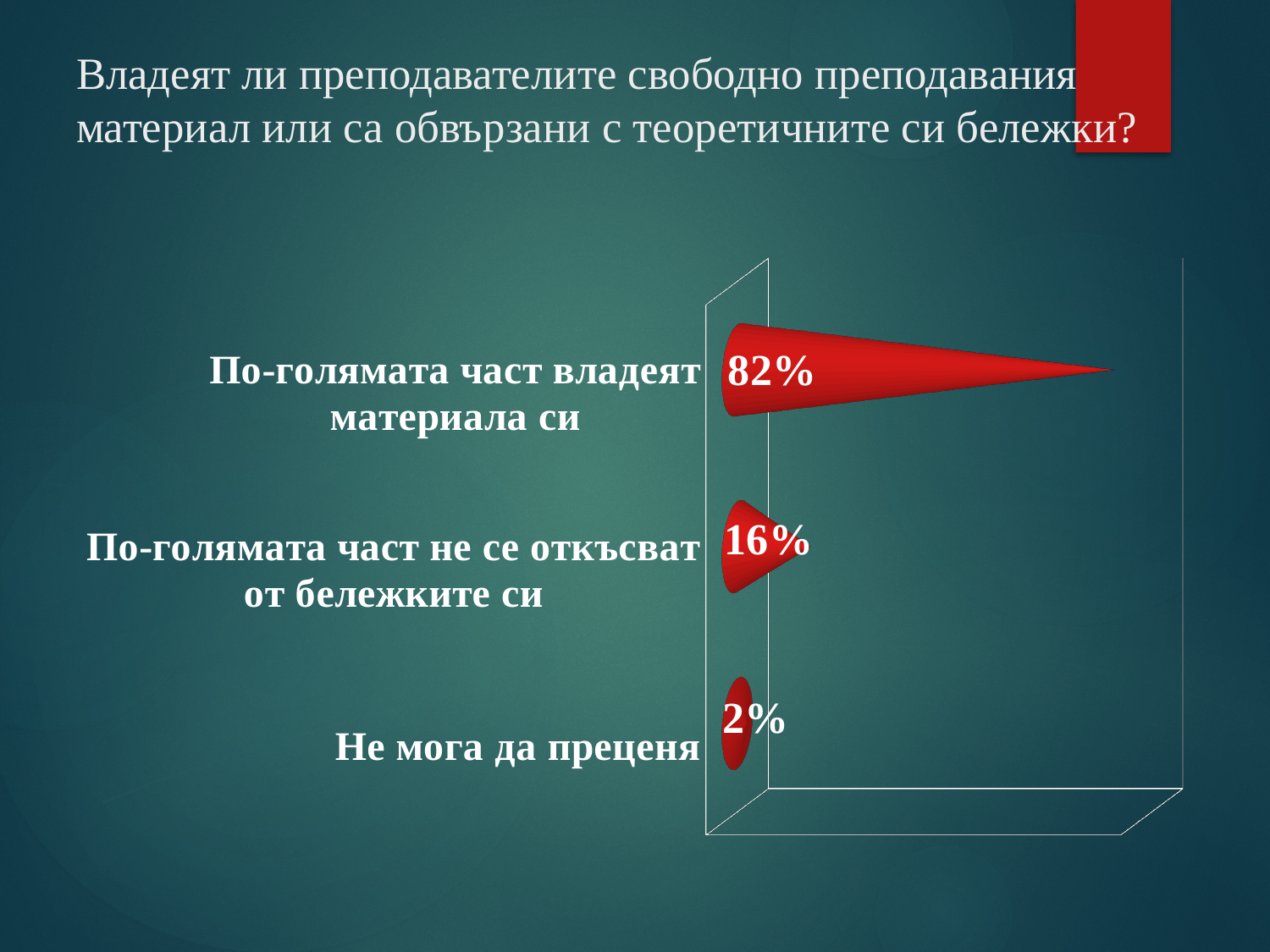
What is the total of the three values shown in the chart? 100% Which is larger: the value for "По-голямата част не се откъсват от бележките си" or the value for "Не мога да преценя"? По-голямата част не се откъсват от бележките си What is the value for "Не мога да преценя"? 2% What is the value for "По-голямата част владеят материала си"? 82% What kind of chart is shown on the slide? Bar chart What is the value for "По-голямата част не се откъсват от бележките си"? 16% How many categories does the chart show? 3 What colour are the bars in the chart? Red What is the difference between the values for "По-голямата част не се откъсват от бележките си" and "Не мога да преценя"? 14% Which category has the highest value? По-голямата част владеят материала си Which category has the lowest value? Не мога да преценя What is the difference between the values for "По-голямата част владеят материала си" and "По-голямата част не се откъсват от бележките си"? 66%